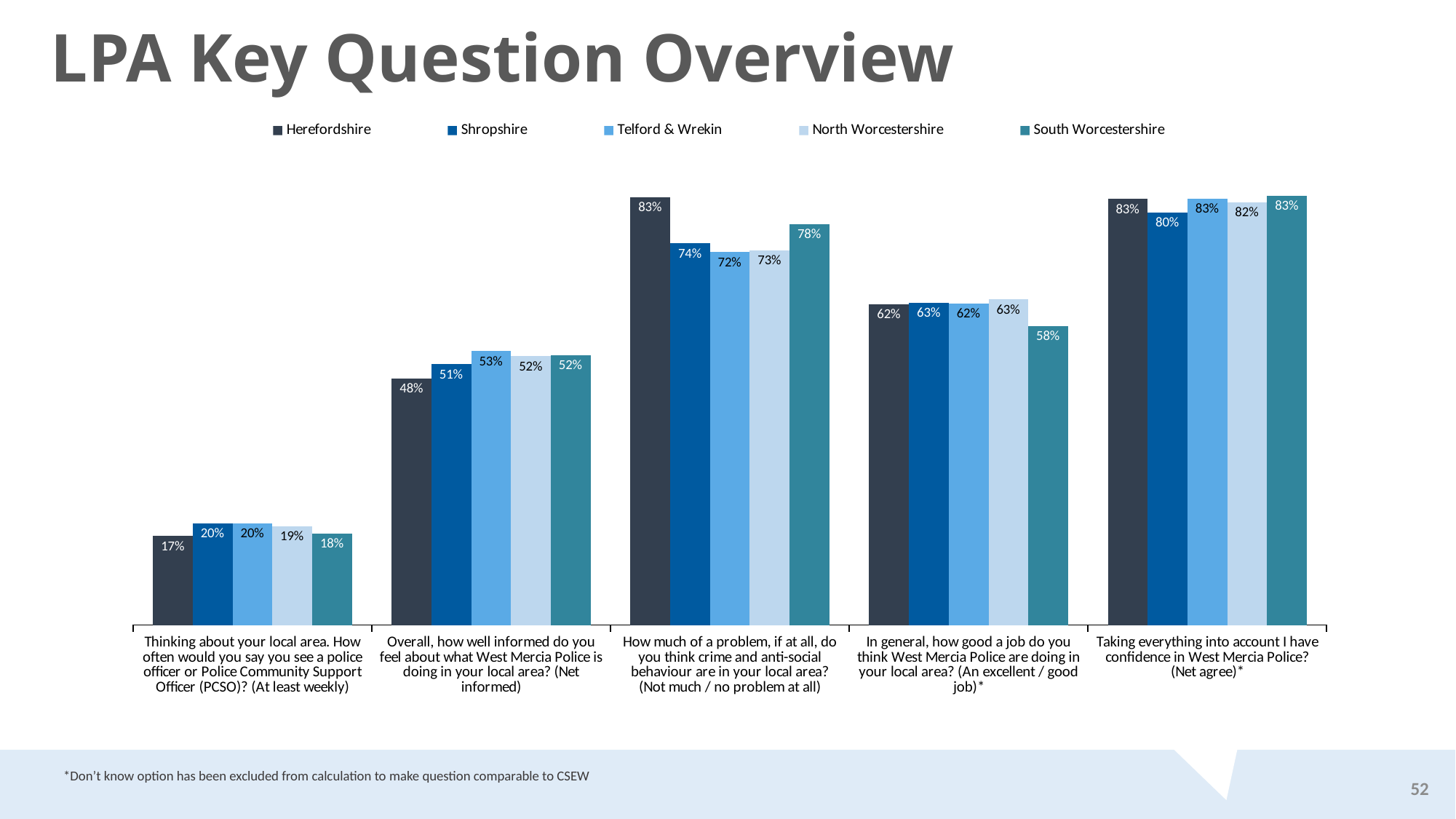
Which area has the lowest value for thinking West Mercia Police are doing an excellent or good job? South Worcestershire What is the difference between Telford & Wrekin and Herefordshire on the question about feeling well informed about what West Mercia Police is doing? 5% What is the difference between Herefordshire and Telford & Wrekin on the question about crime and anti-social behaviour being not much / no problem at all? 11% How many survey questions are shown along the x axis of the chart? 5 Which area has the highest value on the question about crime and anti-social behaviour being not much / no problem at all? Herefordshire What type of chart is shown on the slide? Bar chart What percentage of Herefordshire respondents say they see a police officer or PCSO at least weekly? 17% What is the value for South Worcestershire on the question about how much of a problem crime and anti-social behaviour are in the local area? 78% Which is larger: Shropshire or South Worcestershire on the question about West Mercia Police doing an excellent or good job? Shropshire Which area has the highest value for feeling well informed about what West Mercia Police is doing in the local area? Telford & Wrekin How many areas does the legend list? 5 What is the value for Shropshire on the question about having confidence in West Mercia Police (Net agree)? 80%